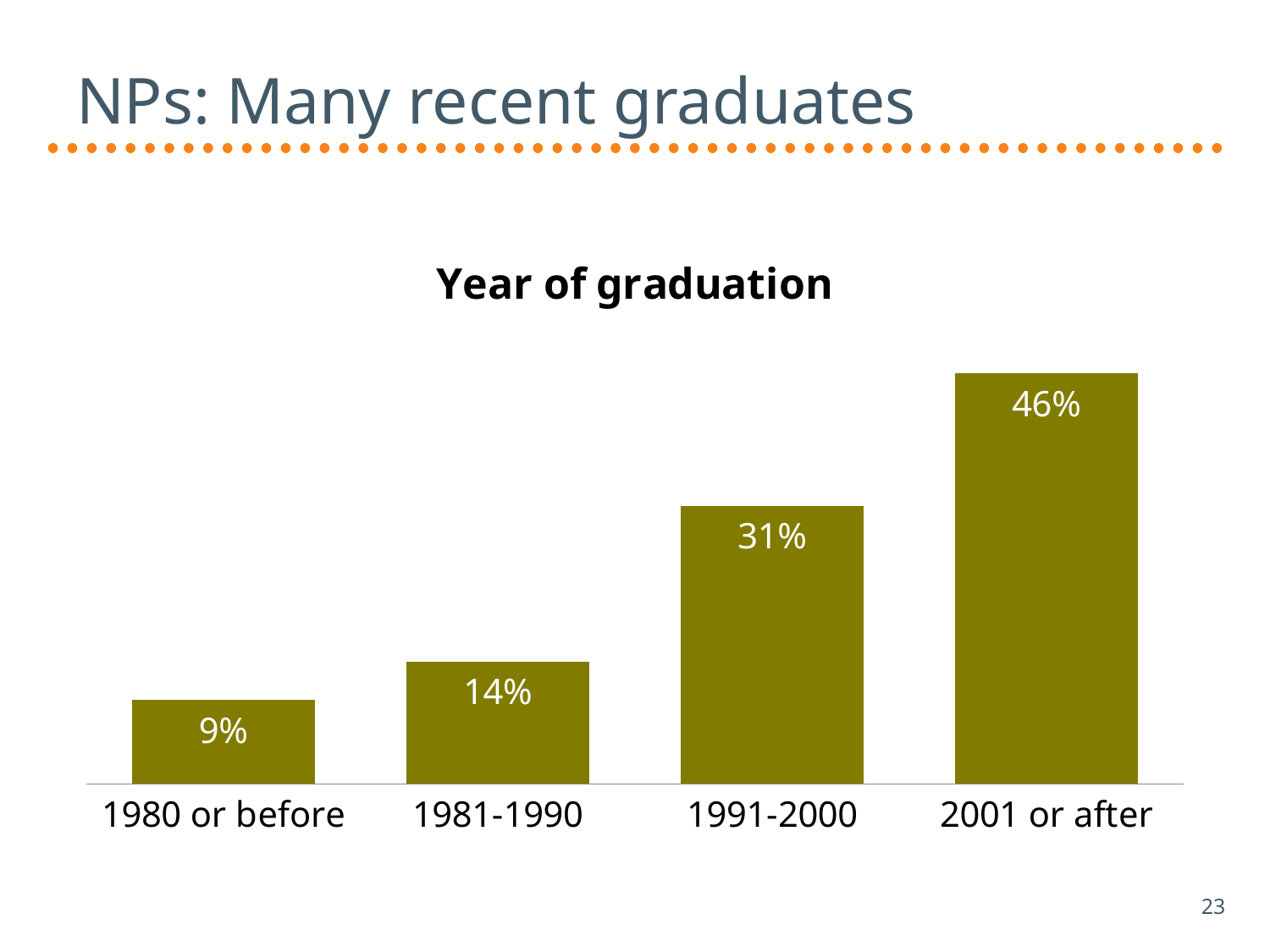
What is the title of the chart? Year of graduation What is the difference between the values for 1981-1990 and 1980 or before? 5% Do the values rise or fall moving from left to right along the x axis? Rise Which year-of-graduation category has the lowest value? 1980 or before How many year-of-graduation categories are shown in the chart? 4 What is the value shown for the 1981-1990 category? 14% Which year-of-graduation category has the highest value? 2001 or after What kind of chart is shown on the slide? Bar chart What percentage is shown for 1991-2000? 31% Which is larger, the value for 1991-2000 or the value for 1981-1990? 1991-2000 What percentage of NPs graduated in 2001 or after? 46% What is the difference between the values for 2001 or after and 1991-2000? 15%